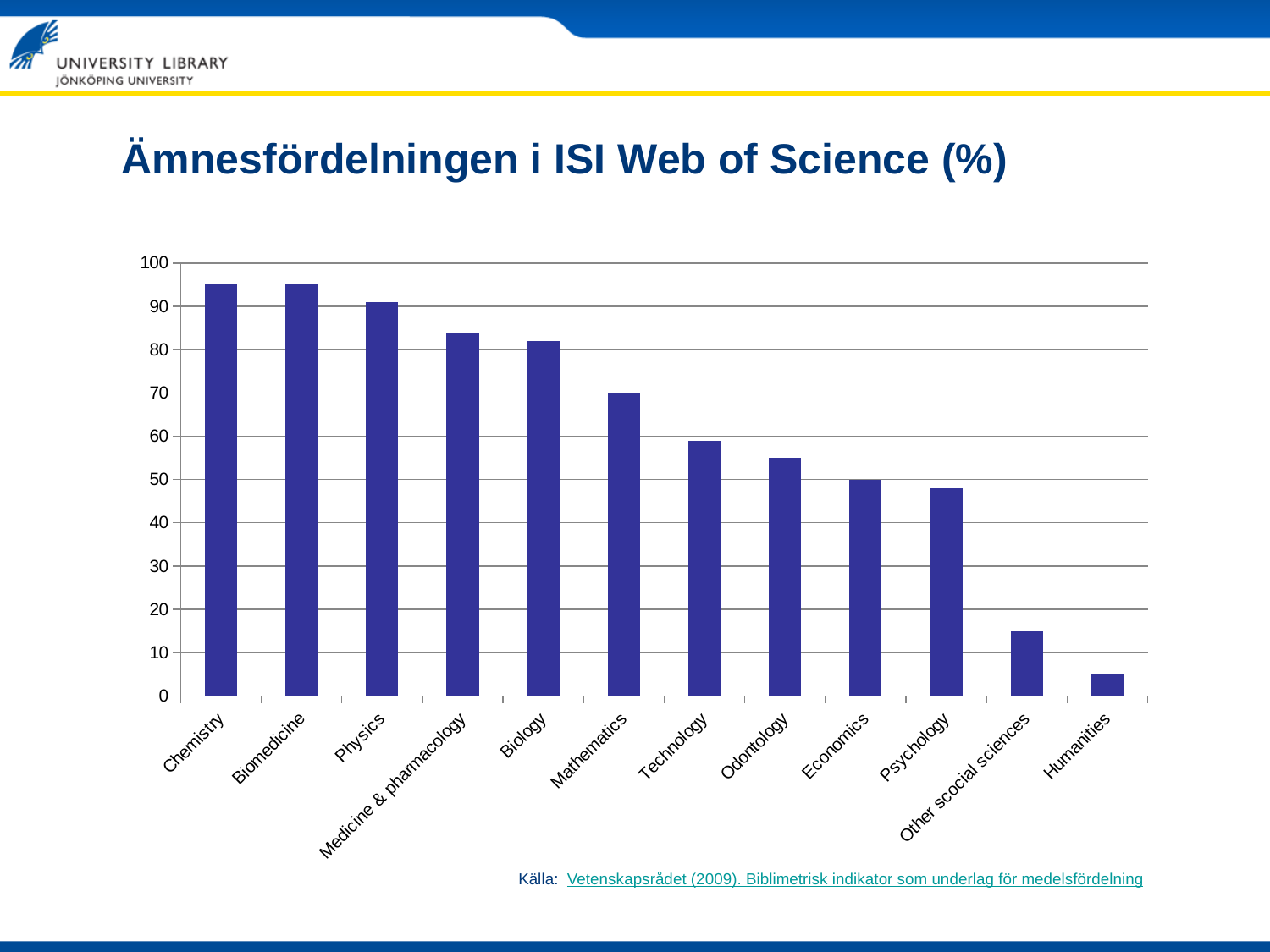
Do the values rise or fall from left to right along the x axis? fall What is the value for Mathematics? 70 What is the title of the chart on the slide? Ämnesfördelningen i ISI Web of Science (%) Is the value for Other scocial sciences greater or less than 20? less What is the value for Economics? 50 What kind of chart is shown on the slide? bar chart Is the value for Chemistry greater or less than 90? greater Which category has the lowest value in the chart? Humanities Which is larger, the value for Physics or the value for Biology? Physics Is the value for Medicine & pharmacology greater or less than 80? greater How many categories are shown on the x axis of the chart? 12